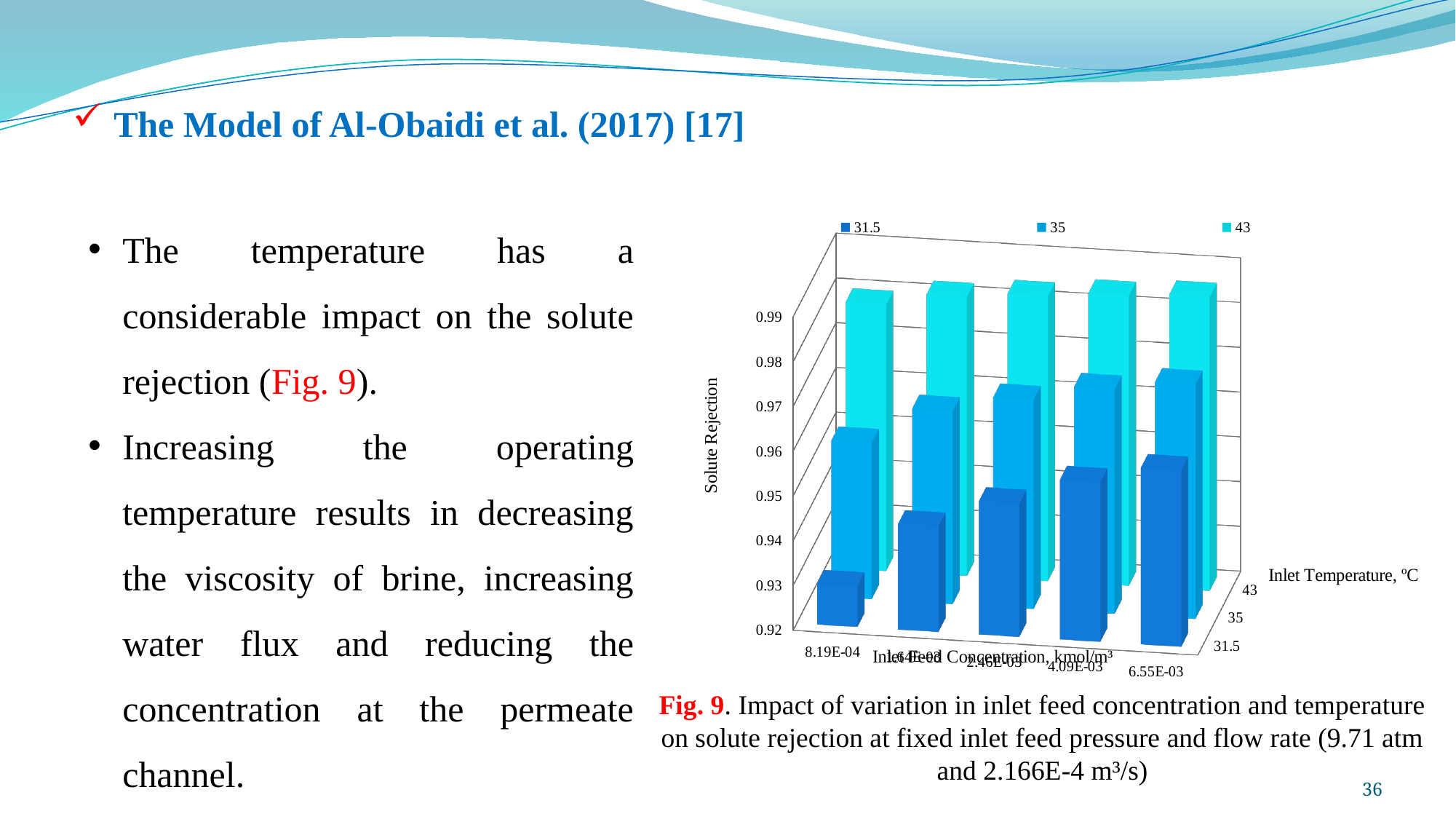
Is the solute rejection for the 31.5 series at 8.19E-04 greater or less than 0.95? less Does solute rejection for the 31.5 series rise or fall as inlet feed concentration increases along the x axis? rise For the 31.5 series, at which inlet feed concentration is solute rejection lowest? 8.19E-04 What kind of chart is shown in Fig. 9? bar chart How many inlet feed concentration categories are plotted along the x axis of the chart? 5 What is the title of the vertical axis of the chart? Solute Rejection What quantity is labelled on the depth axis of the chart? Inlet Temperature, °C For the 31.5 series, at which inlet feed concentration is solute rejection highest? 6.55E-03 Which inlet temperature series has the highest solute rejection values in the chart? 43 Which inlet temperature series has the lowest solute rejection values in the chart? 31.5 At an inlet feed concentration of 8.19E-04, which series has the larger solute rejection, 31.5 or 43? 43 How many series does the legend of the chart list? 3